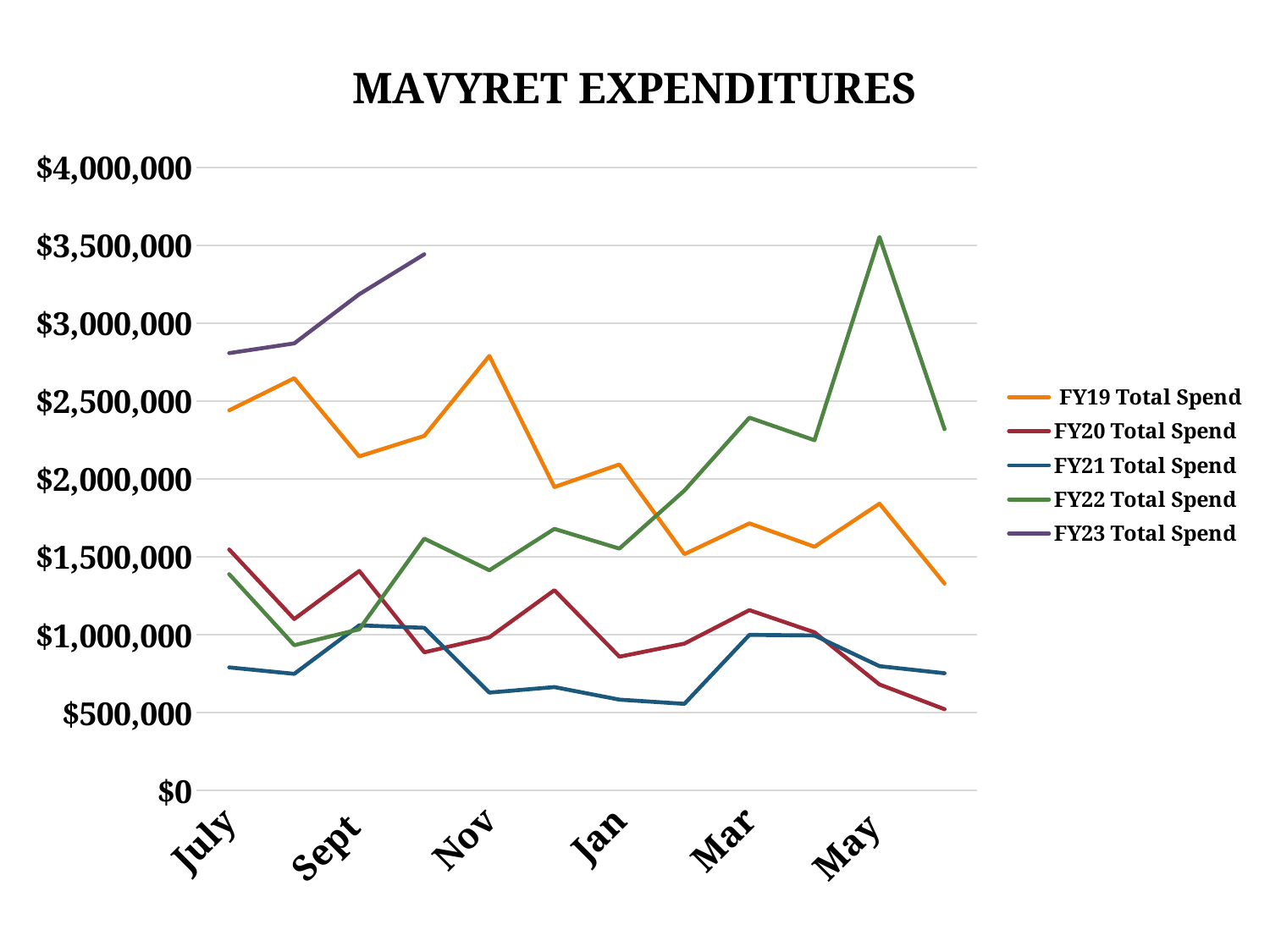
How many series does the legend list? 5 What kind of chart is shown on the slide? line chart Is the value for FY23 Total Spend in Sept greater or less than $3,000,000? greater Which series has the highest value in July? FY23 Total Spend In May, which is larger: FY22 Total Spend or FY19 Total Spend? FY22 Total Spend In which labelled month does FY22 Total Spend reach its highest value? May Is the value for FY19 Total Spend in July greater or less than $2,000,000? greater Is the value for FY22 Total Spend in May greater or less than $3,000,000? greater What is the title of the chart? MAVYRET EXPENDITURES In July, which is larger: FY19 Total Spend or FY22 Total Spend? FY19 Total Spend